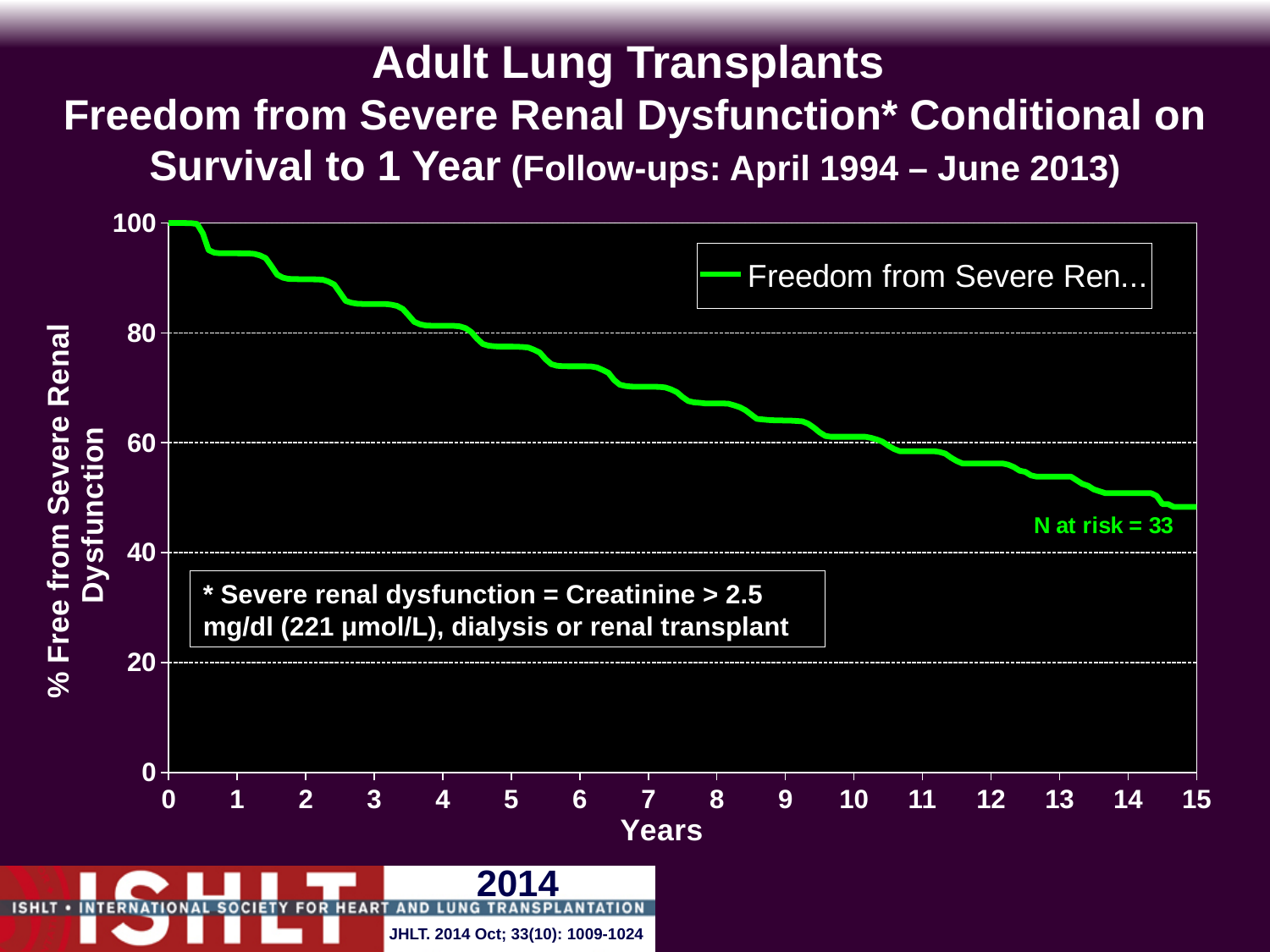
What colour is the plotted line? green Is the value at year 2 greater or less than 80? greater Is the value at year 15 greater or less than 40? greater Is the value at year 12 greater or less than 60? less Does the plotted line rise or fall as the years increase? fall What is the value of the line at year 0? 100 What kind of chart is shown on the slide? line chart What is the N at risk stated on the chart? 33 What is the label of the x axis? Years How many series does the legend list? 1